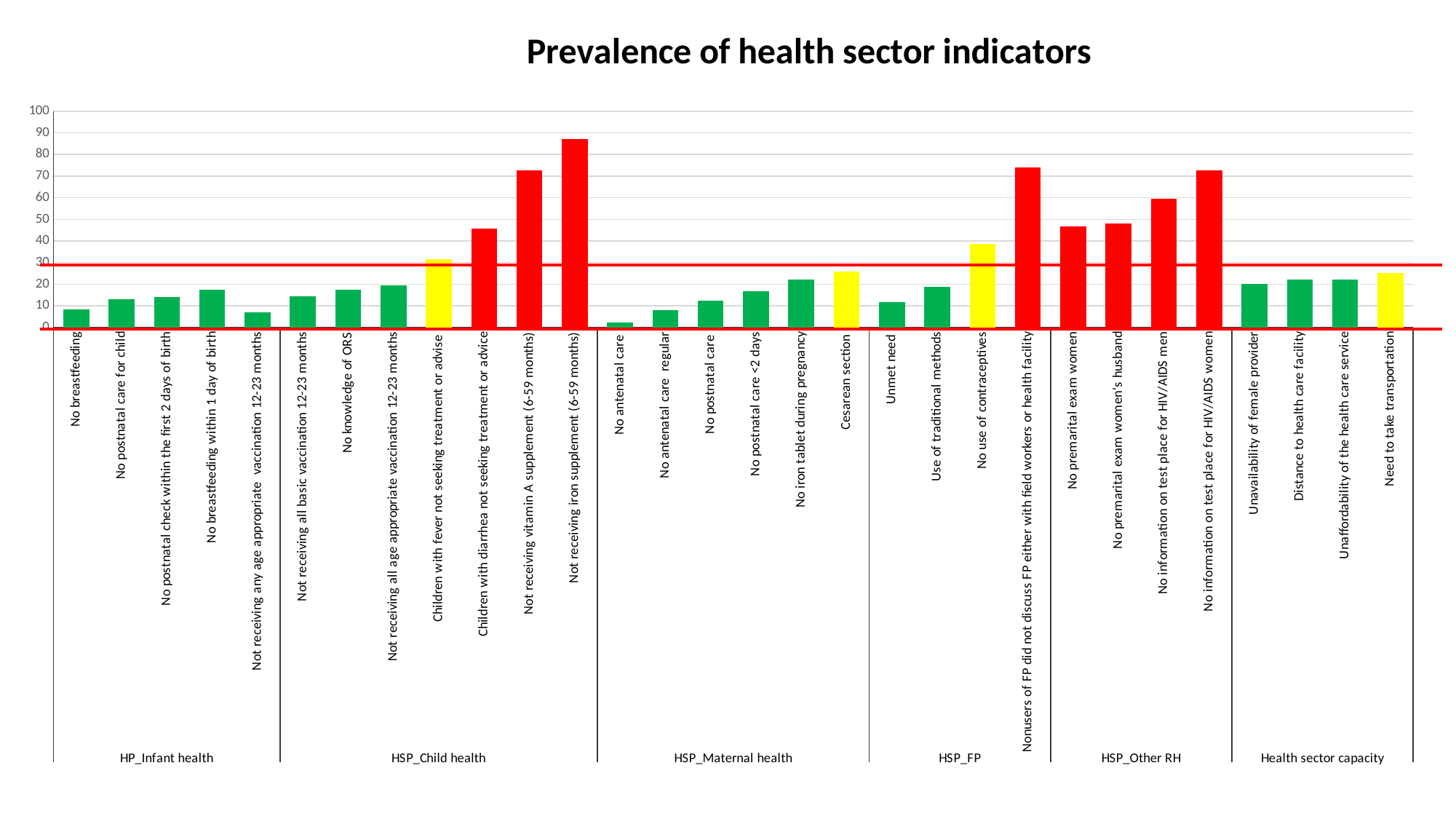
Which indicator has the lowest bar in the chart? No antenatal care Is the value for Not receiving iron supplement (6-59 months) greater or less than 80? greater How many indicator groups (such as HP_Infant health, HSP_Child health) are labelled along the x axis? 6 Which is larger: the value for No use of contraceptives or the value for Unmet need? No use of contraceptives Is the value for No antenatal care greater or less than 10? less Which is larger: the value for Not receiving vitamin A supplement (6-59 months) or the value for Children with diarrhea not seeking treatment or advice? Not receiving vitamin A supplement (6-59 months) Is the value for Cesarean section greater or less than 30? less What is the title of the chart? Prevalence of health sector indicators Which indicator has the highest bar in the chart? Not receiving iron supplement (6-59 months) What kind of chart is shown on the slide? bar chart How many bars are plotted in the chart in total? 30